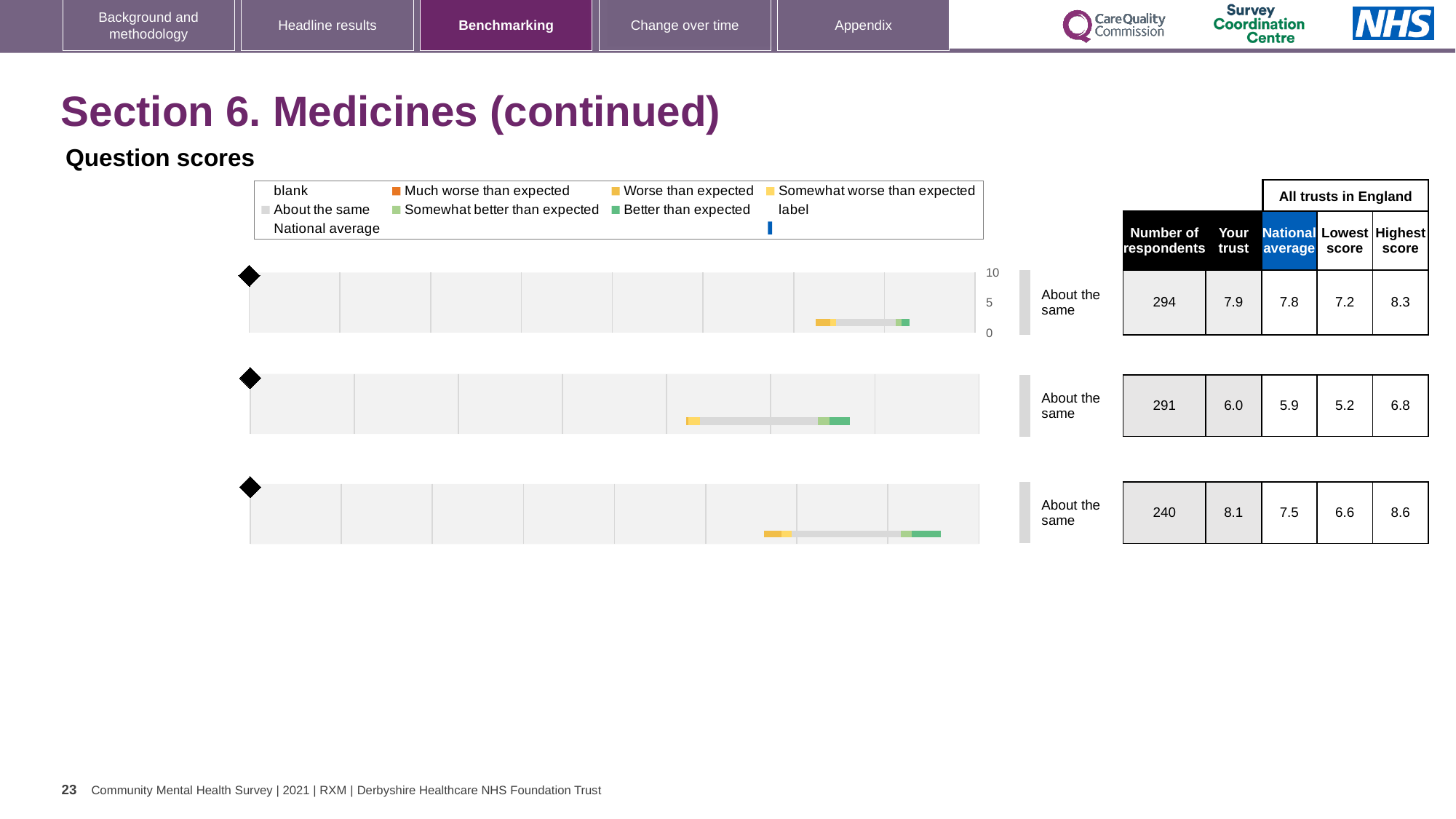
For the bottom chart, what is the difference between the 'Your trust' score and the national average? 0.6 How many question score charts (rows) are shown on the slide? 3 For the middle chart, what is the national average score? 5.9 Which chart (top, middle or bottom) has the lowest 'Lowest score' value? Middle What kind of chart is used to show the question scores on this slide? Bar chart For the top chart, what is the 'Your trust' score? 7.9 For the top chart, what is the number of respondents? 294 What benchmark category is shown next to the top chart? About the same What is the highest value shown on the axis of the top chart? 10 For the top chart, which is larger: the 'Your trust' score or the national average? Your trust Which chart (top, middle or bottom) has the highest 'Your trust' score? Bottom For the bottom chart, what is the highest score among all trusts in England? 8.6